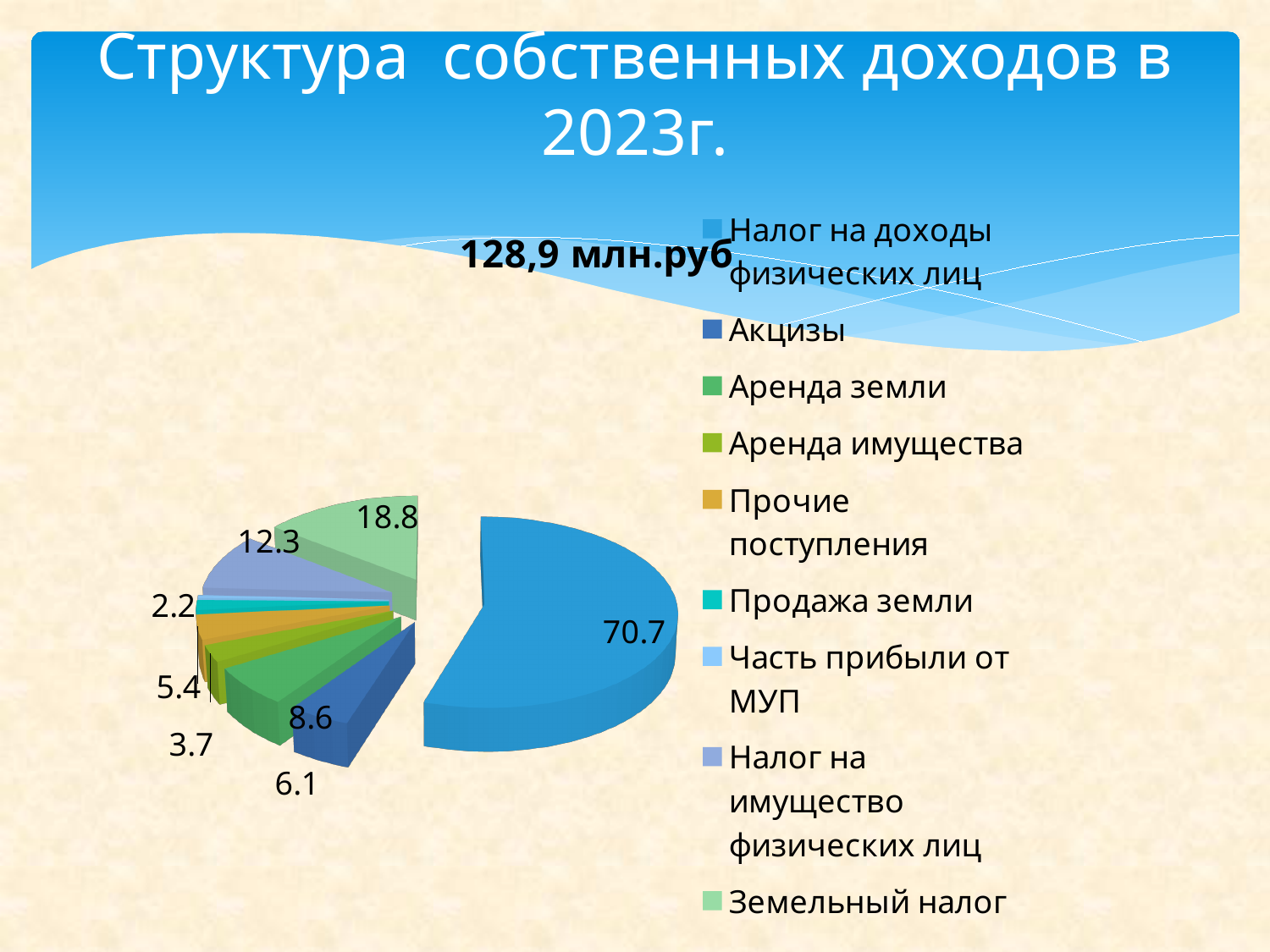
How many categories does the legend list? 9 What value is shown for Продажа земли? 2.2 What value is shown for Земельный налог? 18.8 What value is shown for Акцизы? 6.1 What value is shown for Аренда земли? 8.6 What value is shown for Налог на имущество физических лиц? 12.3 Which is larger, Земельный налог or Налог на имущество физических лиц? Земельный налог What kind of chart is shown on the slide? pie chart What is the difference between the values for Налог на доходы физических лиц and Земельный налог? 51.9 What value is shown for Налог на доходы физических лиц? 70.7 Which category has the largest slice of the pie? Налог на доходы физических лиц What is the title shown above the pie chart? 128,9 млн.руб